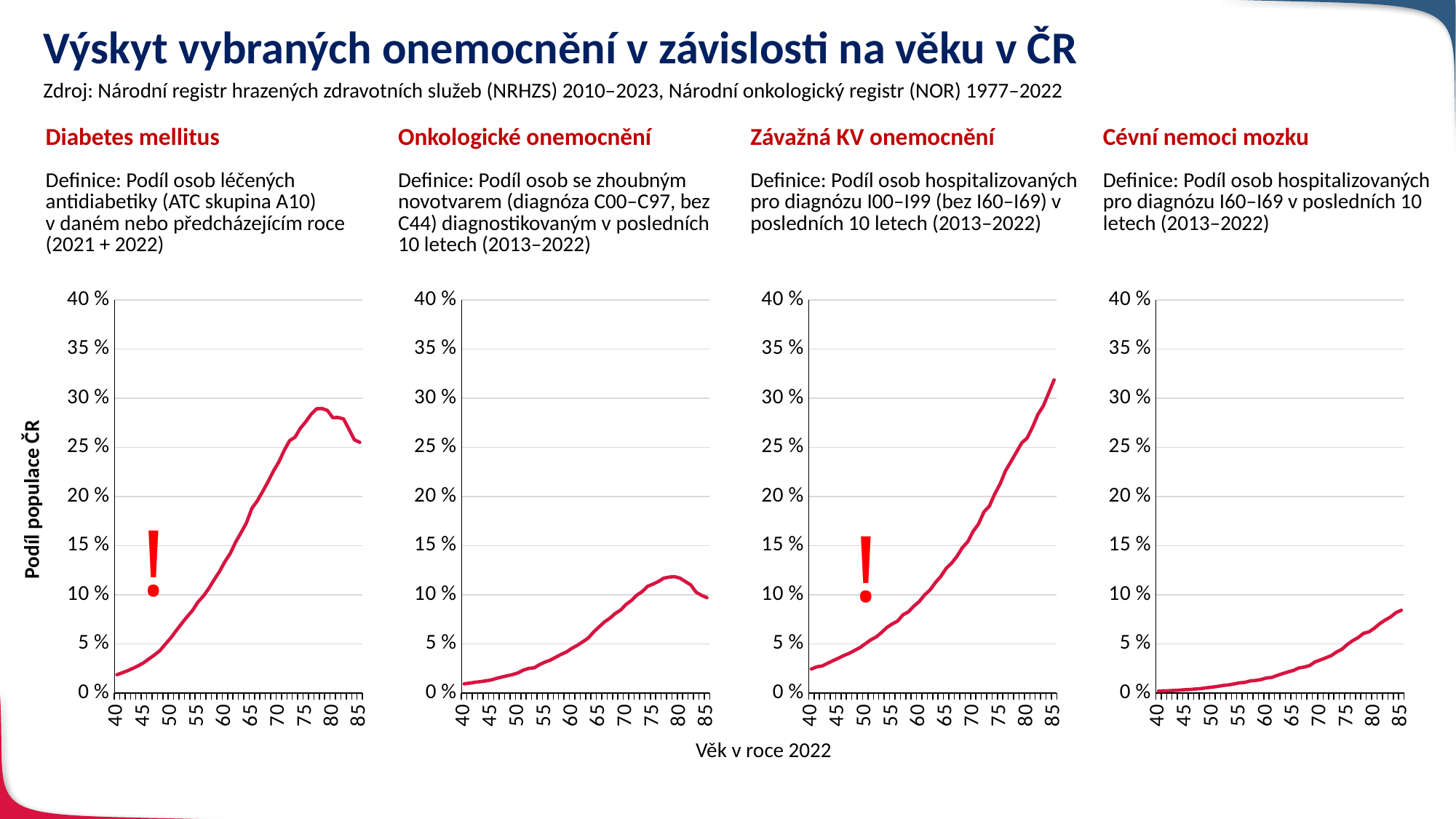
What is the label of the shared vertical axis on the slide? Podíl populace ČR In the Diabetes mellitus chart, does the value rise or fall between age 80 and age 85? falls In the Cévní nemoci mozku chart, is the value at age 70 greater or less than 5 %? less At age 85, which of the four charts shows the lowest value? Cévní nemoci mozku In the Diabetes mellitus chart, is the value at age 85 greater or less than 20 %? greater What kind of chart is used for the Diabetes mellitus panel? line chart How many charts are shown on the slide? 4 In the Cévní nemoci mozku chart, is the value at age 85 greater or less than 10 %? less In the Závažná KV onemocnění chart, does the value rise or fall as age increases from 40 to 85? rises At age 85, which of the four charts shows the highest value? Závažná KV onemocnění